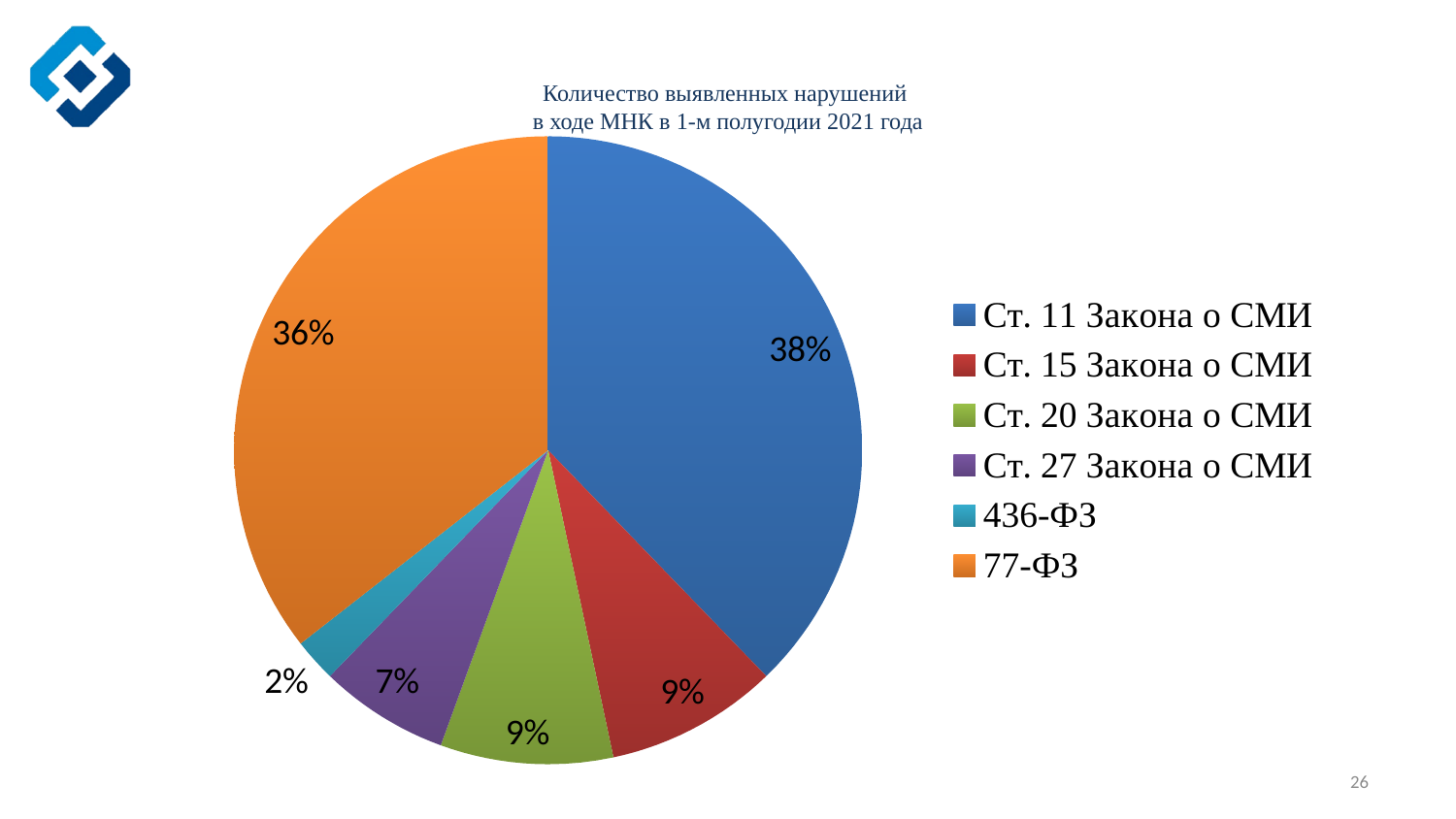
Which is larger, the share for Ст. 27 Закона о СМИ or the share for 436-ФЗ? Ст. 27 Закона о СМИ What is the value shown for 436-ФЗ? 2% What is the value shown for Ст. 15 Закона о СМИ? 9% What is the value shown for Ст. 27 Закона о СМИ? 7% Which category has the largest slice of the pie? Ст. 11 Закона о СМИ What share of the pie does Ст. 11 Закона о СМИ account for? 38% What colour is the slice for 77-ФЗ? Orange Which category has the smallest slice of the pie? 436-ФЗ How many categories does the pie chart show? 6 What kind of chart is shown on the slide? Pie chart What share of the pie does 77-ФЗ account for? 36% What is the difference between the shares of Ст. 11 Закона о СМИ and 77-ФЗ? 2%